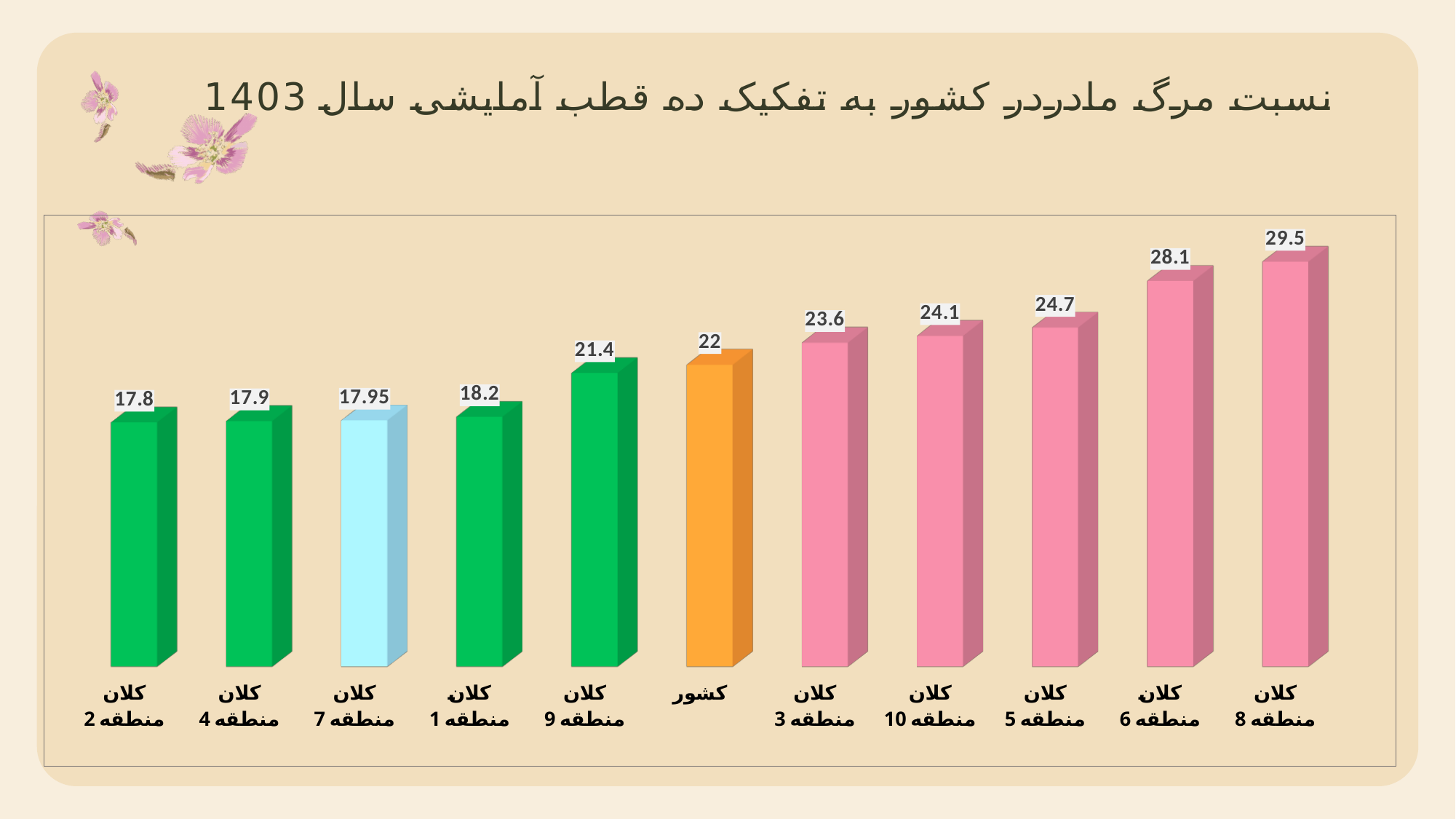
Which is larger, the value for کلان منطقه 5 or the value for کلان منطقه 3? کلان منطقه 5 What colour is the bar for کشور (Country)? Orange What is the value for کلان منطقه 10 (Macro-region 10)? 24.1 What is the value for کشور (Country)? 22 How many bars are shown in the chart? 11 What is the difference between the values for کلان منطقه 8 and کلان منطقه 2? 11.7 What kind of chart is shown on the slide? Bar chart What is the value for کلان منطقه 7 (Macro-region 7)? 17.95 What is the value for کلان منطقه 8 (Macro-region 8)? 29.5 Which category has the highest value? کلان منطقه 8 (Macro-region 8) Which category has the lowest value? کلان منطقه 2 (Macro-region 2) What is the difference between the values for کلان منطقه 6 and کشور? 6.1